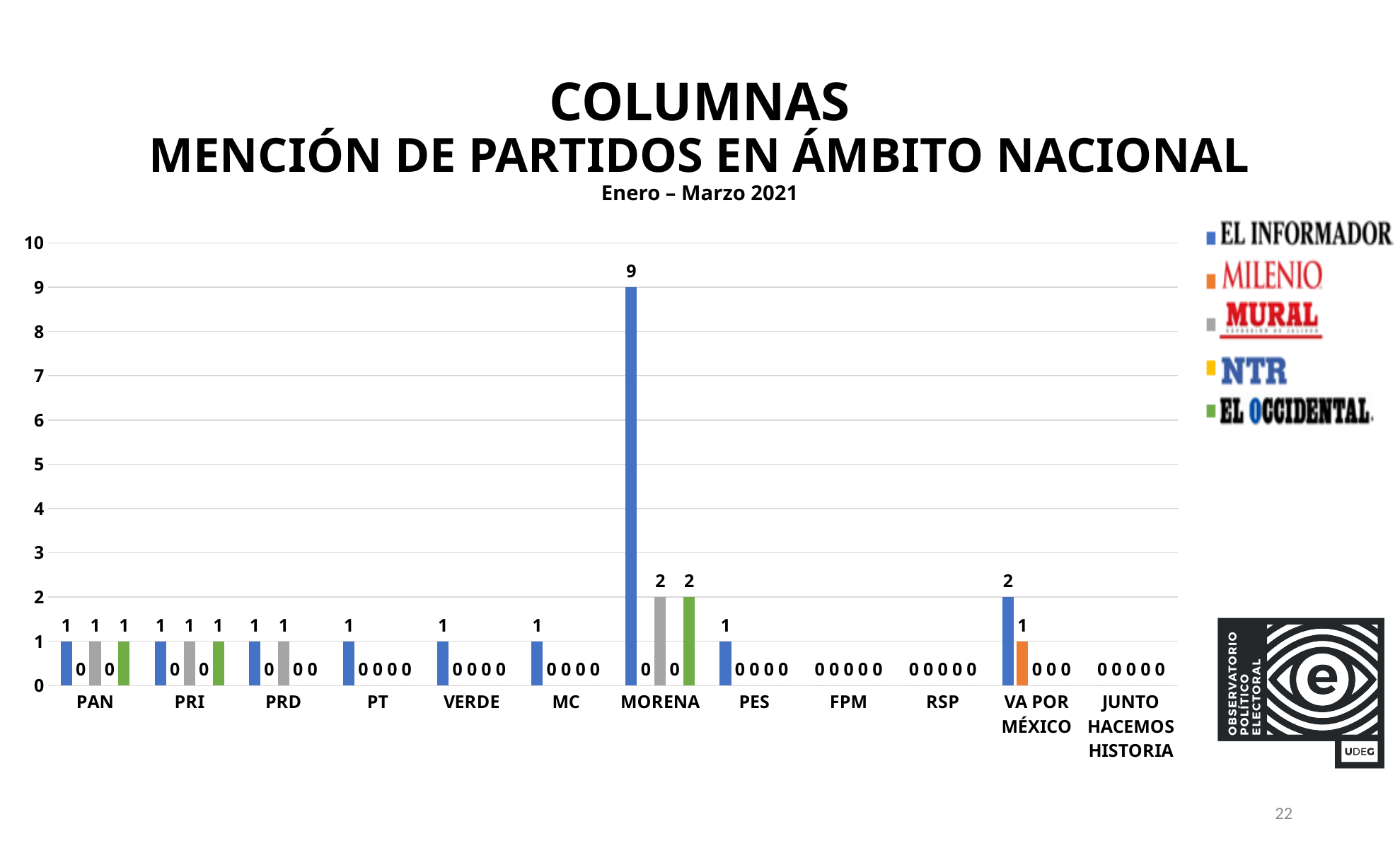
What is the value for VA POR MÉXICO in the MILENIO series? 1 What is the value for MORENA in the EL INFORMADOR series? 9 What kind of chart is shown on the slide? Bar chart Which is larger, the EL INFORMADOR value for MORENA or the EL INFORMADOR value for PES? MORENA Which party has the highest value in the EL INFORMADOR series? MORENA What is the difference between the EL INFORMADOR values for MORENA and VA POR MÉXICO? 7 How many party categories are shown on the x axis? 12 What is the total of all series values for MORENA? 13 What period does the chart subtitle cover? Enero – Marzo 2021 What is the value for MORENA in the EL OCCIDENTAL series? 2 How many series does the legend list? 5 What is the value for PRD in the MURAL series? 1